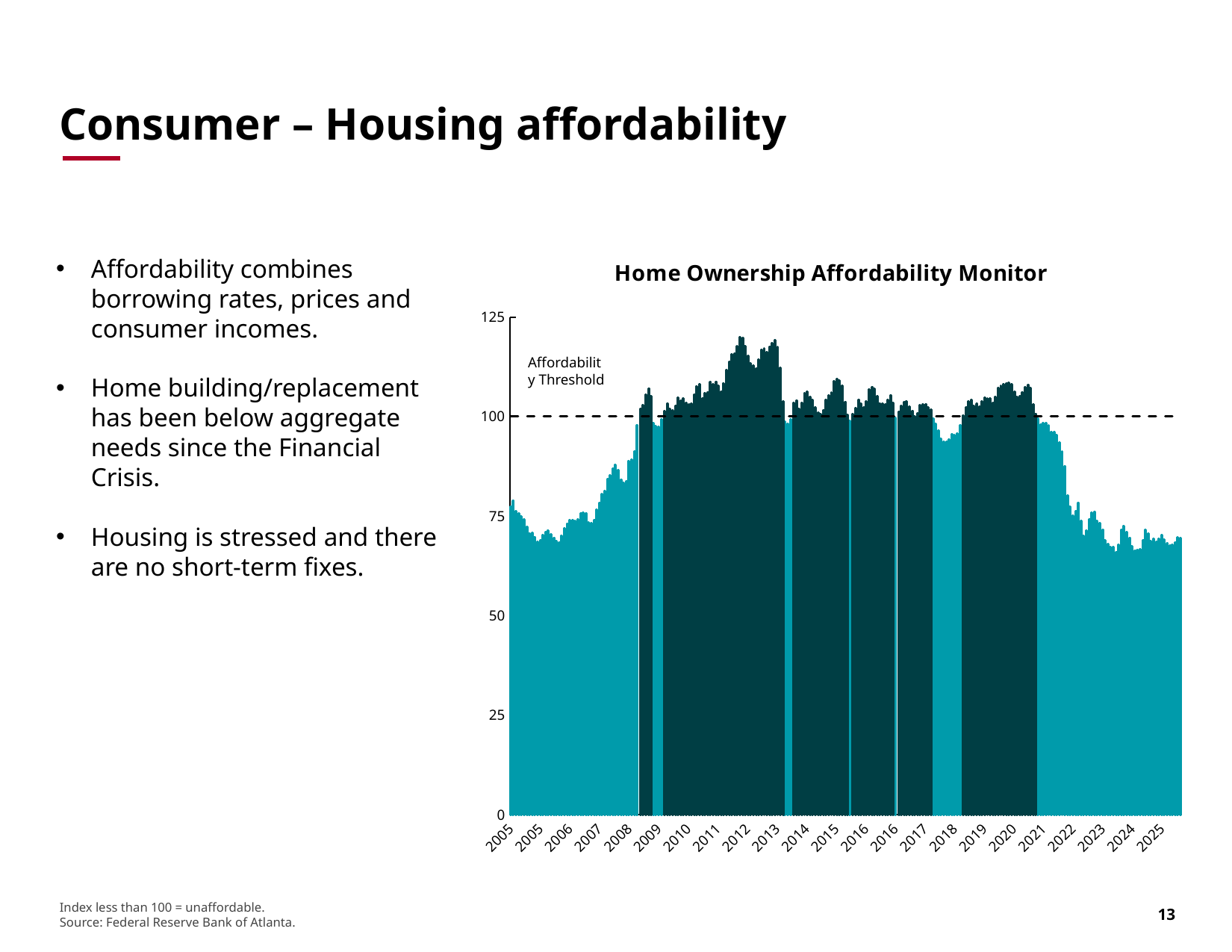
Does the index rise or fall between 2021 and 2025? fall Is the value of the index in 2007 greater or less than 100? less What is the title of the chart on the slide? Home Ownership Affordability Monitor What kind of chart is the Home Ownership Affordability Monitor? bar chart Is the value of the index in 2019 greater or less than 100? greater Is the value of the index in 2022 greater or less than 100? less At what value on the y axis is the dashed Affordability Threshold line drawn? 100 Which is larger, the index value in 2012 or in 2024? 2012 In which year does the index reach its highest level? 2012